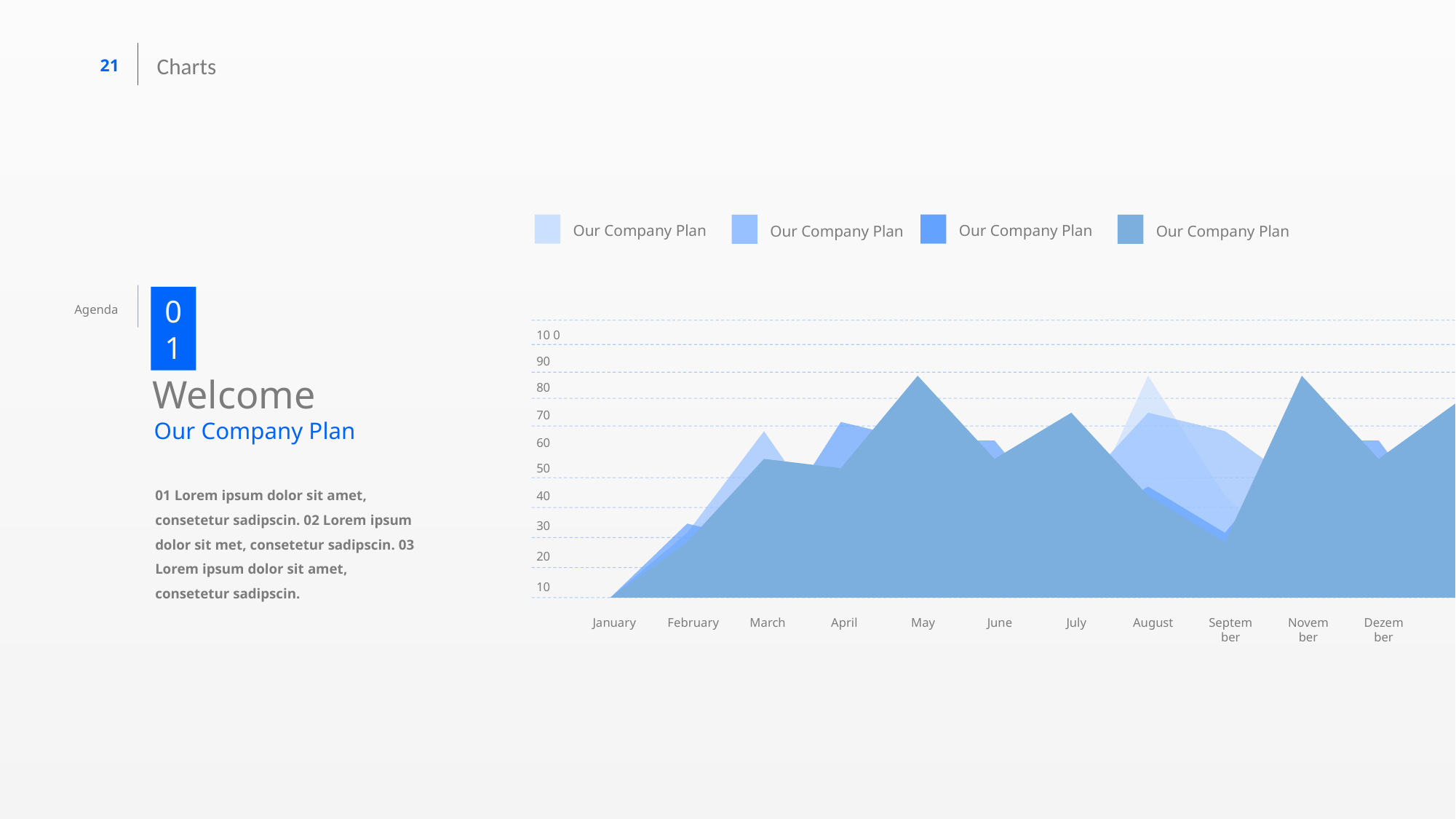
How many months are shown along the x axis of the chart? 11 Is the highest value plotted for January greater or less than 20? less Do the plotted values rise or fall from January to May? rise What is the first month shown on the x axis of the chart? January Is the highest value plotted for May greater or less than 80? greater How many series does the chart legend list? 4 Is the highest value plotted for February greater or less than 50? less What kind of chart is shown on the slide? Area chart Which month has the lowest plotted values in the chart? January Is the highest value plotted for May larger or smaller than the highest value plotted for June? larger What label is given to every entry in the chart legend? Our Company Plan